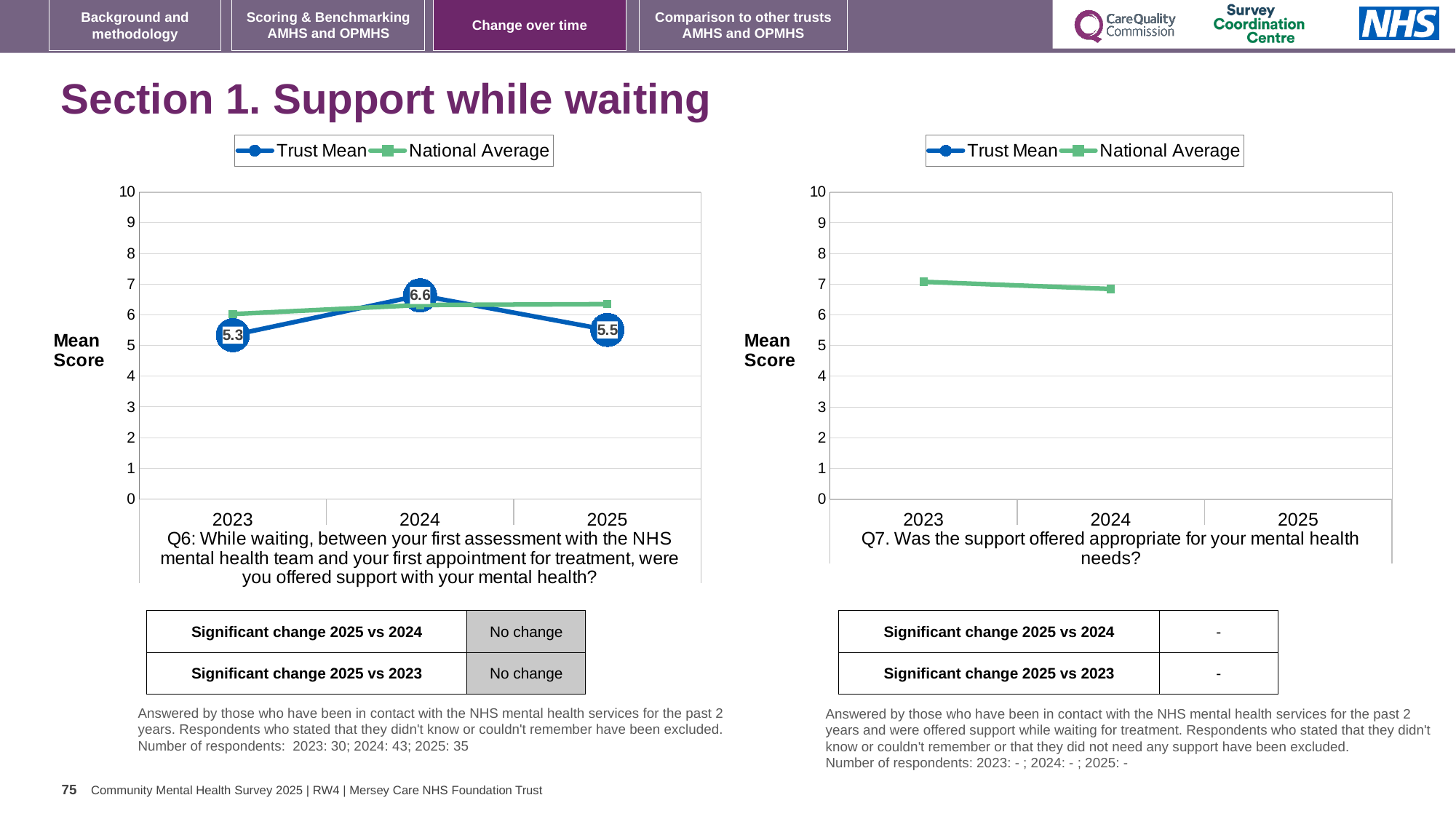
What kind of chart is the Q6 chart on the left? Line chart In the Q6 chart on the left, what is the difference between the Trust Mean scores for 2024 and 2023? 1.3 How many years are shown on the x axis of the Q6 chart on the left? 3 In the Q6 chart on the left, what is the Trust Mean score for 2025? 5.5 In the Q6 chart on the left, which year has the highest Trust Mean score? 2024 In the Q7 chart on the right, is the National Average value for 2023 greater or less than 6? greater In the Q6 chart on the left, is the Trust Mean score higher in 2024 or in 2025? 2024 In the Q6 chart on the left, what is the Trust Mean score for 2023? 5.3 In the Q6 chart on the left, is the National Average value for 2023 greater or less than 5? greater How many series does the legend of the Q7 chart on the right list? 2 In the Q6 chart on the left, which year has the lowest Trust Mean score? 2023 In the Q6 chart on the left, what is the Trust Mean score for 2024? 6.6